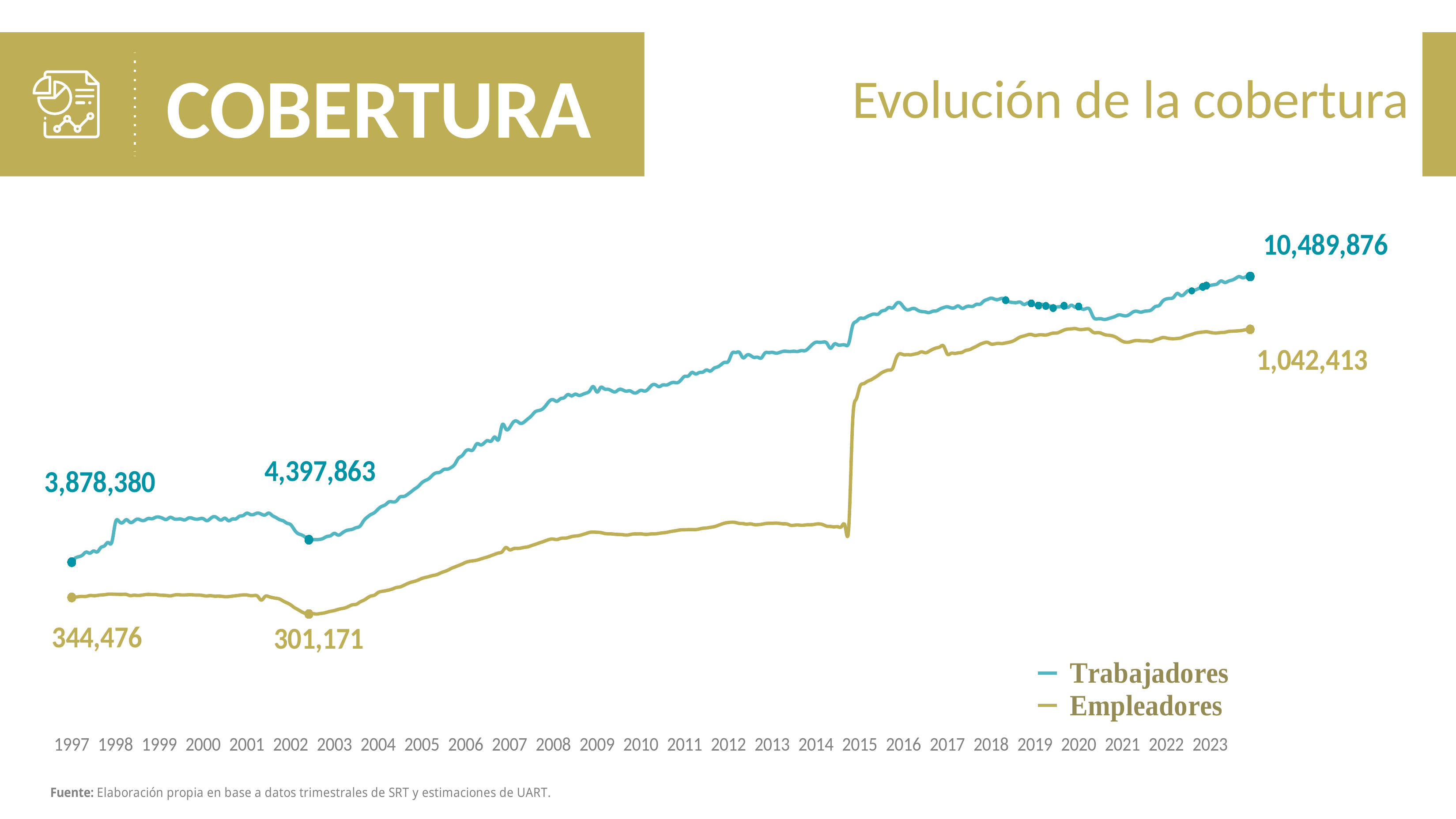
By how much did the labelled Trabajadores value increase from 1997 to 2023? 6,611,496 Which series has the higher value in 2023, Trabajadores or Empleadores? Trabajadores What is the labelled value for Empleadores at the end of the series in 2023? 1,042,413 What is the difference between the Empleadores value in 1997 (344,476) and its labelled dip value around 2002–2003 (301,171)? 43,305 How many years are labelled on the x axis? 27 What kind of chart is shown on the slide? line chart What is the labelled value for Trabajadores at the start of the series in 1997? 3,878,380 How many series does the legend list? 2 What is the labelled value for Trabajadores at the end of the series in 2023? 10,489,876 Overall, does the Trabajadores line rise or fall from 1997 to 2023? rise What is the labelled value for Empleadores at the start of the series in 1997? 344,476 What is the labelled value for Empleadores at the dip around 2002–2003? 301,171